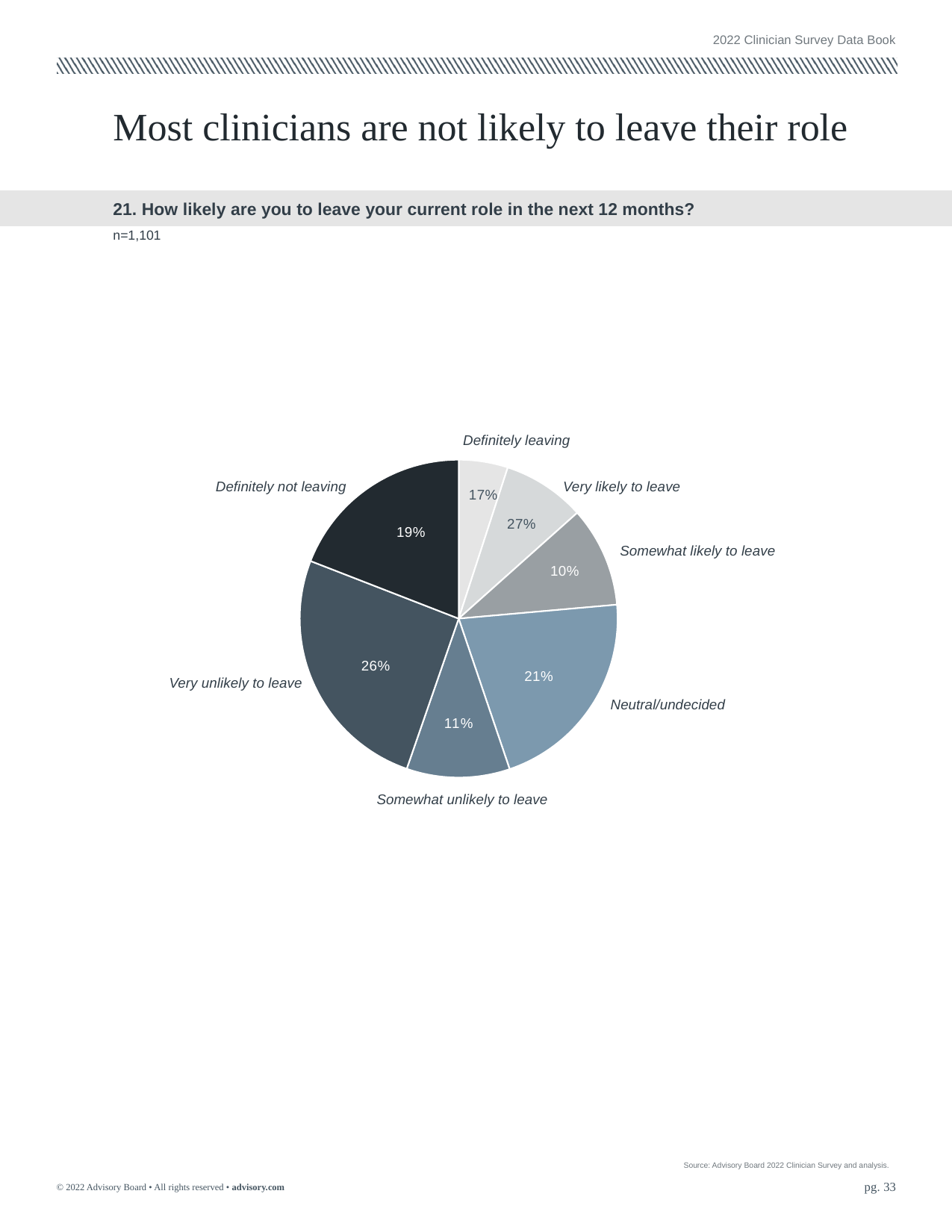
What is the difference between the printed values for 'Neutral/undecided' and 'Somewhat unlikely to leave'? 10% What survey question does the pie chart answer? 21. How likely are you to leave your current role in the next 12 months? How many slices does the pie chart have? 7 What percentage is shown for the 'Neutral/undecided' slice? 21% What percentage is shown for the 'Somewhat likely to leave' slice? 10% What percentage is shown for the 'Very unlikely to leave' slice? 26% What percentage is shown for the 'Definitely leaving' slice? 17% What kind of chart is shown on the slide? pie chart What percentage is shown for the 'Somewhat unlikely to leave' slice? 11% What is the sample size (n) stated for the chart? n=1,101 What percentage is shown for the 'Very likely to leave' slice? 27% What percentage is shown for the 'Definitely not leaving' slice? 19%